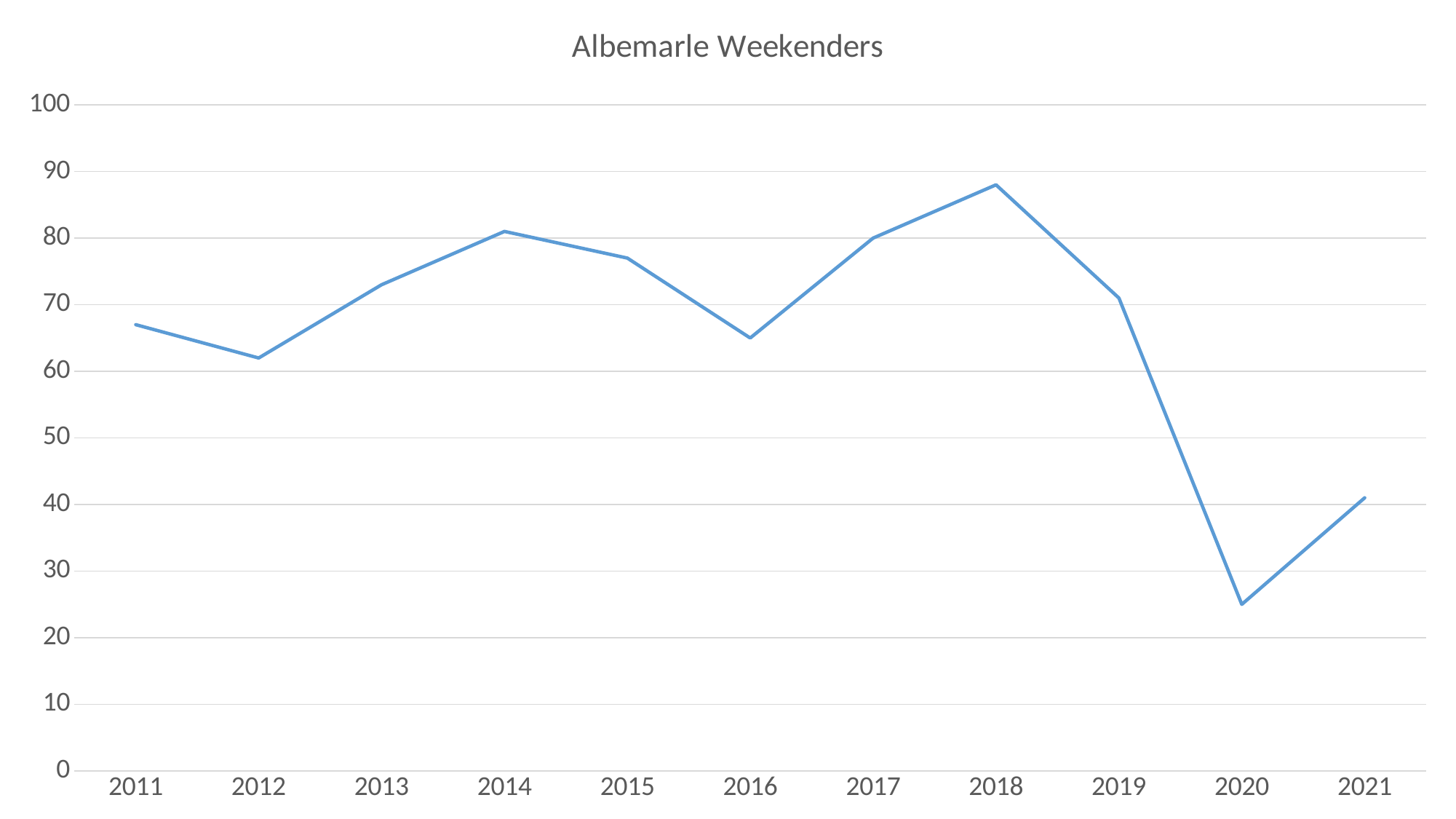
Is the value for 2021 greater or less than 50? less Is the value for 2018 greater or less than 80? greater What kind of chart is shown on the slide? line chart Which is larger, the value for 2020 or the value for 2021? 2021 Is the value for 2020 greater or less than 30? less Do the values rise or fall from 2018 to 2020? fall What is the title of the chart? Albemarle Weekenders How many years are plotted along the x axis? 11 Which year has the lowest value? 2020 Which is larger, the value for 2017 or the value for 2016? 2017 Which year has the highest value? 2018